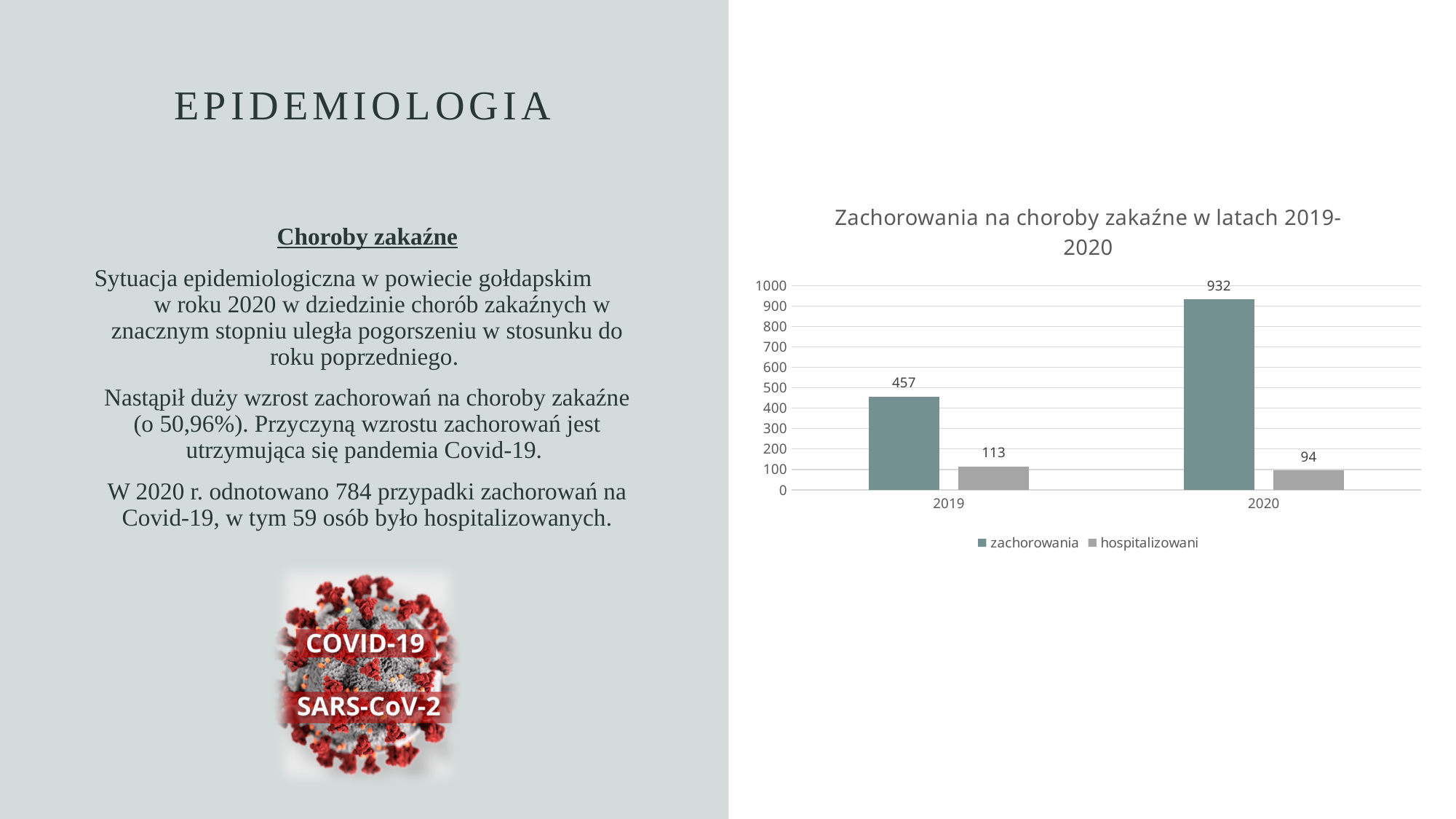
What kind of chart is shown on the slide? Bar chart What is the value of zachorowania for 2020? 932 What is the value of zachorowania for 2019? 457 Which year has the lower value for hospitalizowani? 2020 What is the difference between zachorowania in 2020 and 2019? 475 Is the value for hospitalizowani in 2019 larger than the value for hospitalizowani in 2020? Yes Which year has the higher value for zachorowania? 2020 What is the value of hospitalizowani for 2019? 113 How many series does the legend list? 2 What is the title of the chart? Zachorowania na choroby zakaźne w latach 2019-2020 What is the value of hospitalizowani for 2020? 94 What is the difference between hospitalizowani in 2019 and 2020? 19